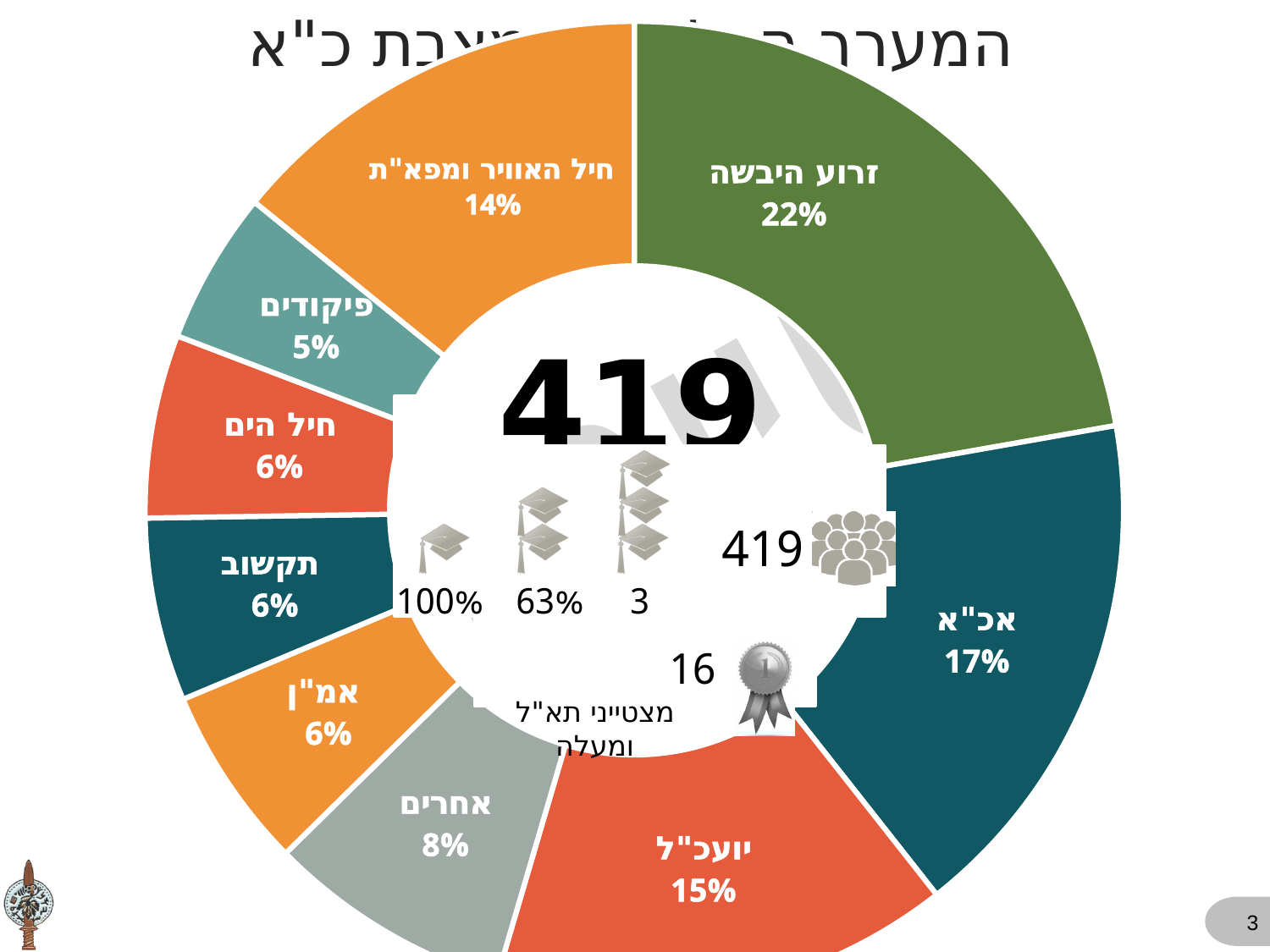
What kind of chart is shown on the slide? pie chart (donut) What percentage is shown for אכ"א? 17% Which segment has the smallest share of the chart? פיקודים Which is larger, the share for אחרים or the share for אמ"ן? אחרים What is the difference in percentage points between זרוע היבשה and יועכ"ל? 7 How many segments does the chart have? 9 What is the difference in percentage points between אכ"א and חיל האוויר ומפא"ת? 3 What percentage is shown for חיל האוויר ומפא"ת? 14% What percentage is shown for זרוע היבשה? 22% Which segment has the largest share of the chart? זרוע היבשה What percentage is shown for פיקודים? 5% What number is printed in the centre of the chart? 419